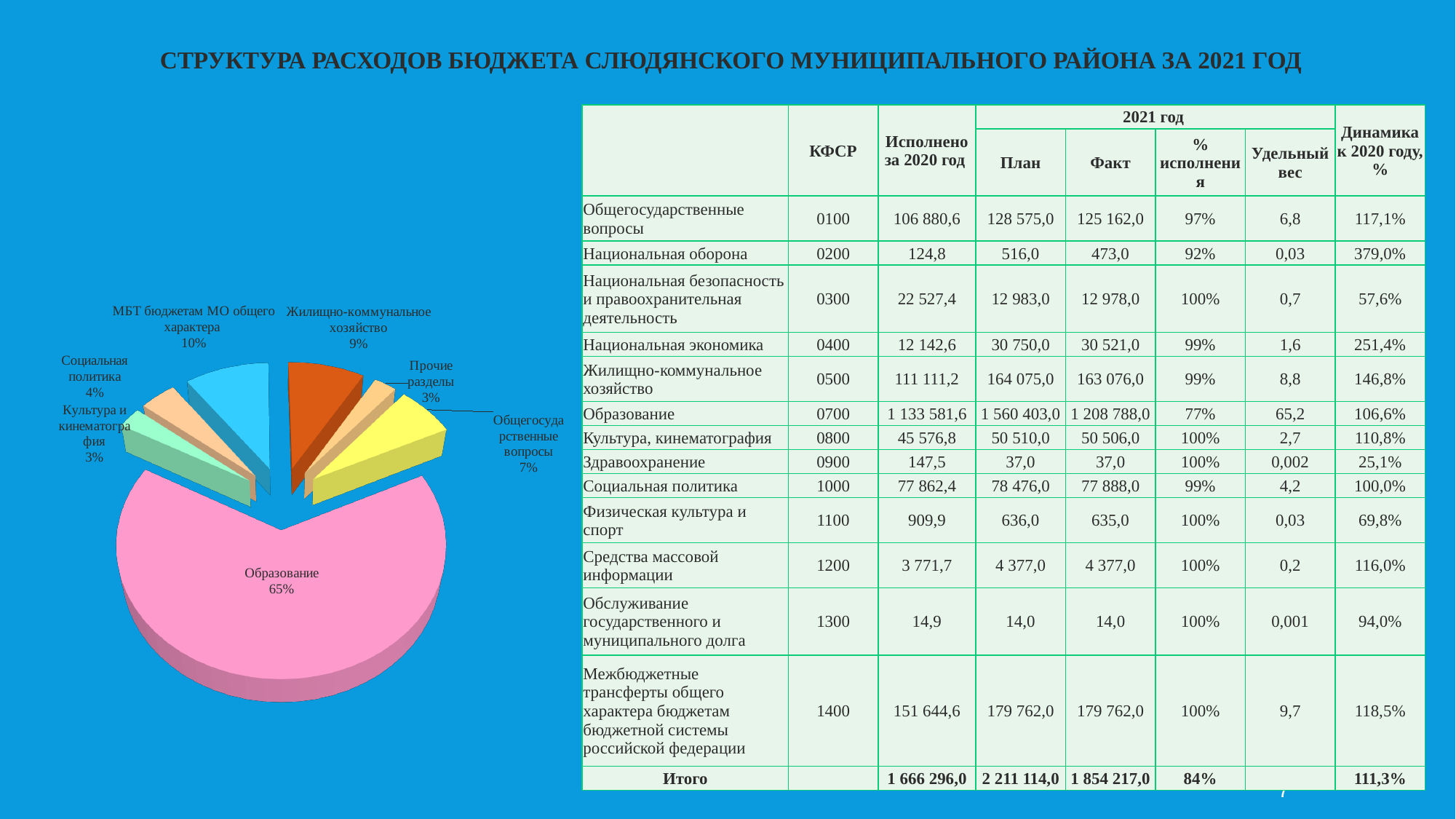
What percentage is shown for МБТ бюджетам МО общего характера in the pie chart? 10% What share of the pie chart does Образование hold? 65% What colour is the Образование slice in the pie chart? Pink What is the difference in percentage points between Общегосударственные вопросы and Социальная политика in the pie chart? 3 How many slices does the pie chart have? 7 What type of chart is shown on the left of the slide? Pie chart Which slice of the pie chart is the largest? Образование What percentage is shown for Жилищно-коммунальное хозяйство in the pie chart? 9% In the pie chart, which is larger: МБТ бюджетам МО общего характера or Жилищно-коммунальное хозяйство? МБТ бюджетам МО общего характера What is the difference in percentage points between Образование and МБТ бюджетам МО общего характера in the pie chart? 55 What percentage is shown for Общегосударственные вопросы in the pie chart? 7% What percentage is shown for Социальная политика in the pie chart? 4%